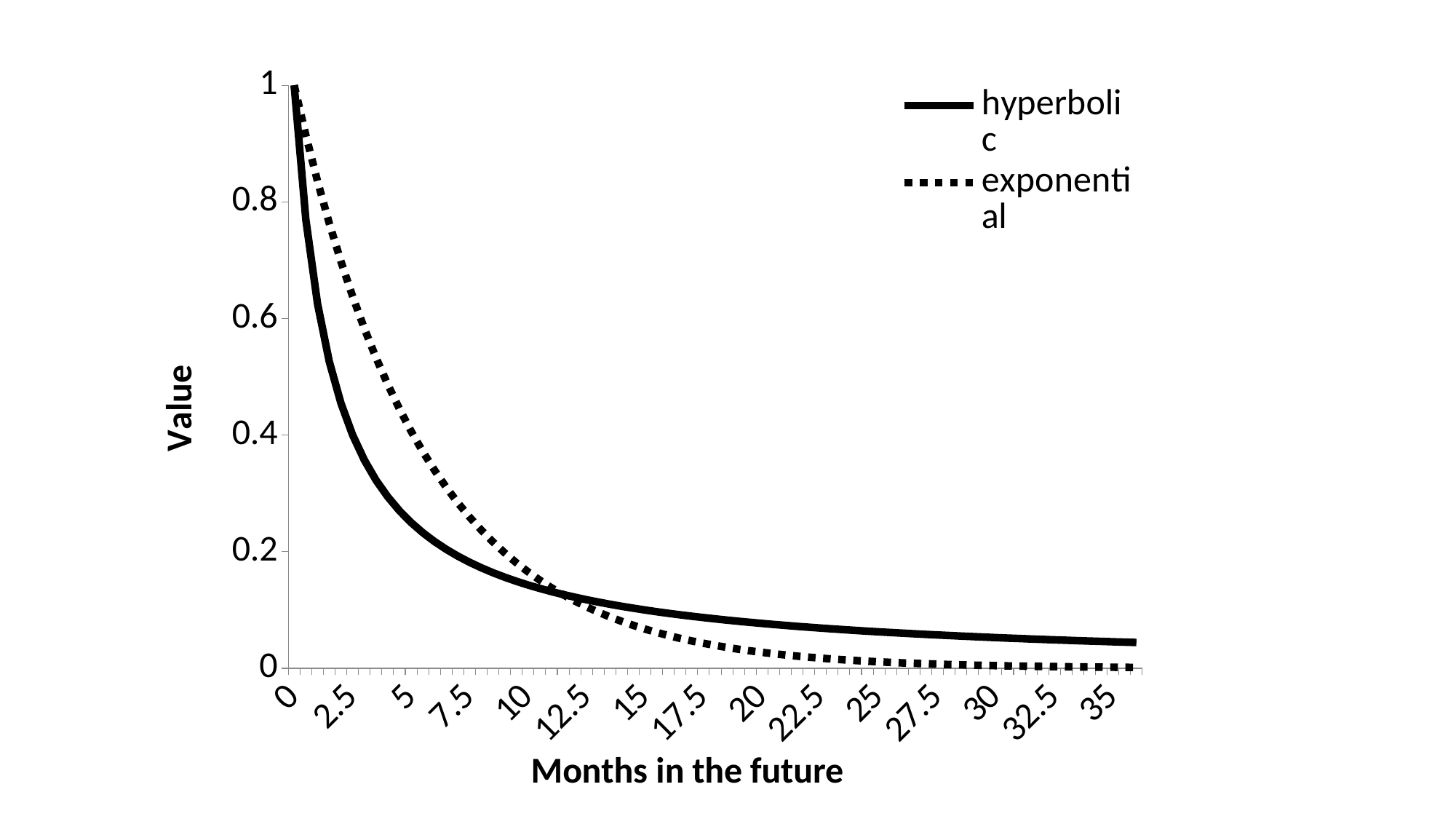
What is the value of the hyperbolic series at 0 months in the future? 1 Which series is drawn with a dotted line? exponential At 25 months in the future, which series has the higher value, hyperbolic or exponential? hyperbolic Is the value of the exponential series at 25 months greater or less than 0.2? less What is the value of the exponential series at 0 months in the future? 1 What is the title of the x axis? Months in the future At 5 months in the future, which series has the higher value, hyperbolic or exponential? exponential Do the values of the hyperbolic series rise or fall as months in the future increase? fall What kind of chart is shown on the slide? line chart Is the value of the hyperbolic series at 5 months greater or less than 0.4? less How many series does the legend list? 2